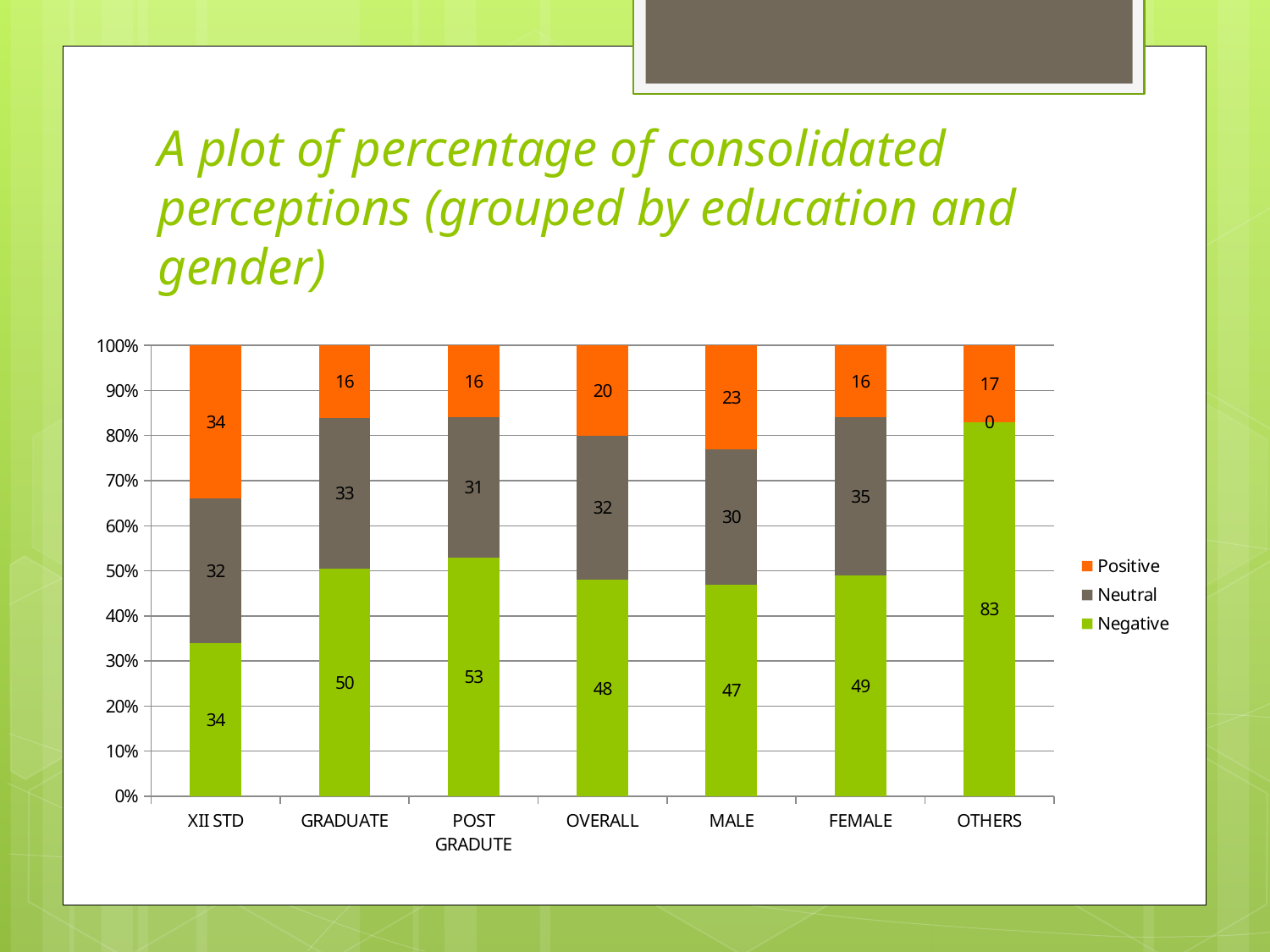
What is the difference between the Negative values for POST GRADUATE and XII STD? 19 Which category has the highest Negative value? OTHERS Which category has the lowest Neutral value? OTHERS How many series does the legend list? 3 Which series is shown in orange in the legend? Positive What is the Positive value for MALE? 23 How many categories are shown on the x axis? 7 What is the Positive value for XII STD? 34 What is the Neutral value for FEMALE? 35 What kind of chart is shown on the slide? Stacked bar chart Which is larger, the Positive value for OVERALL or the Positive value for GRADUATE? OVERALL What is the Negative value for OTHERS? 83